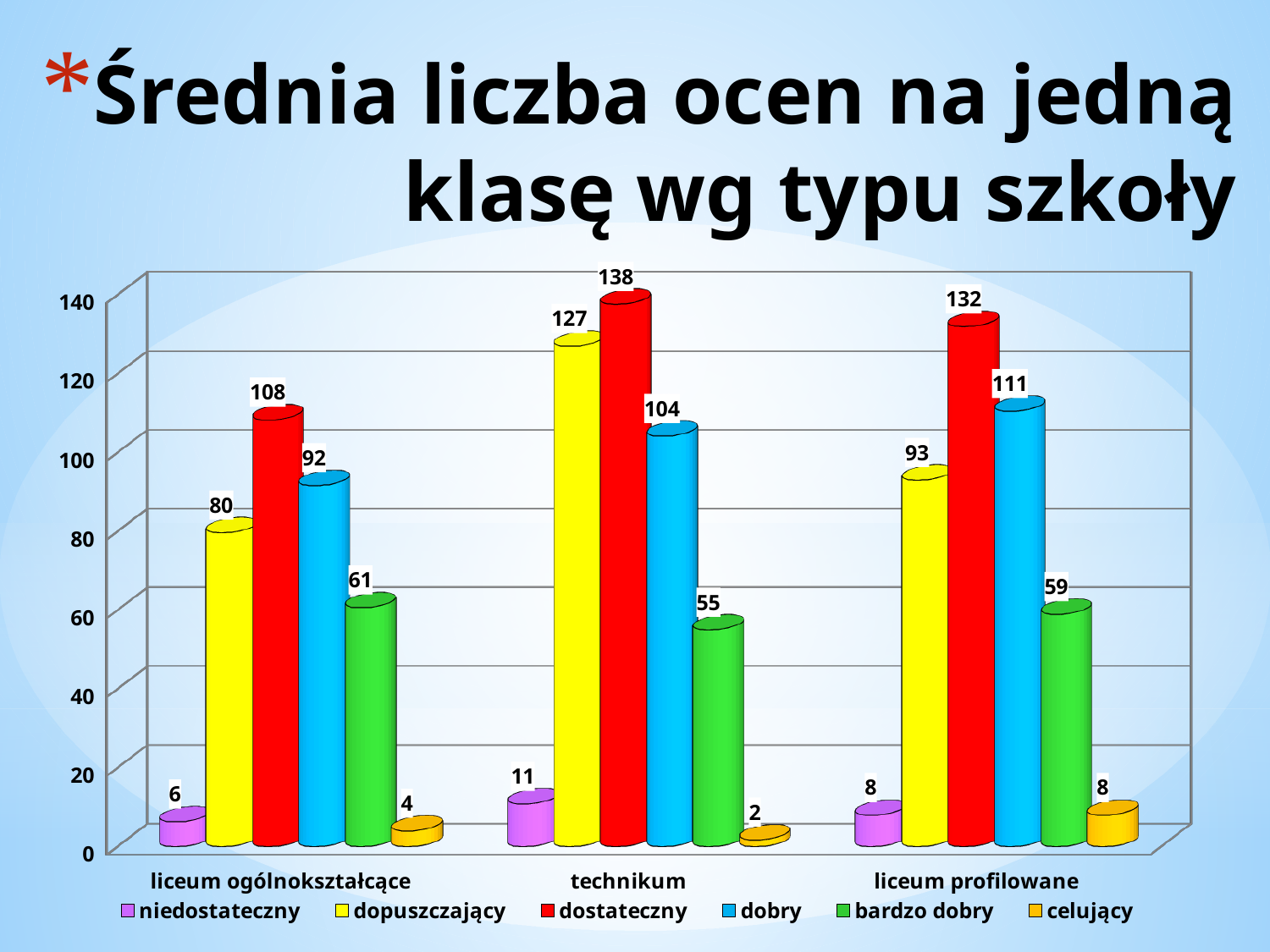
What is the title of the slide? Średnia liczba ocen na jedną klasę wg typu szkoły Which school type has the lowest value for celujący? technikum What is the value for celujący in liceum ogólnokształcące? 4 How many school types are shown on the x axis? 3 Which colour represents the dostateczny series? red What is the value for dostateczny in technikum? 138 Which school type has the highest value for dopuszczający? technikum Which is larger: bardzo dobry in liceum ogólnokształcące or bardzo dobry in liceum profilowane? liceum ogólnokształcące What is the value for dobry in liceum profilowane? 111 What is the difference between the dostateczny values for technikum and liceum ogólnokształcące? 30 What kind of chart is shown on the slide? bar chart How many series does the legend list? 6